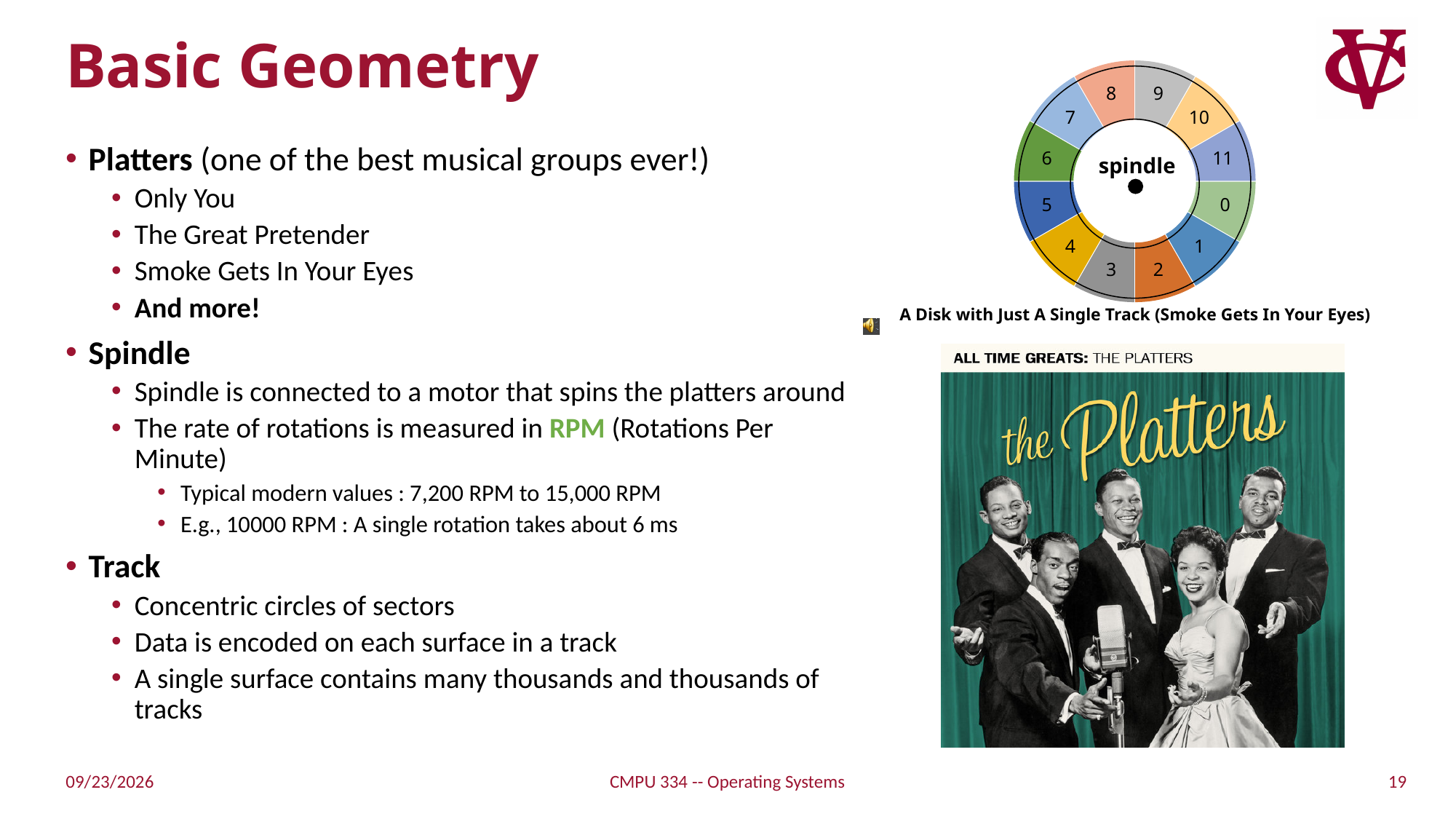
What label appears at the center of the disk diagram? spindle What is the lowest sector number shown on the disk diagram? 0 How many numbered sectors does the single-track disk diagram show? 12 What is the highest sector number shown on the disk diagram? 11 What is the caption printed below the disk diagram? A Disk with Just A Single Track (Smoke Gets In Your Eyes)